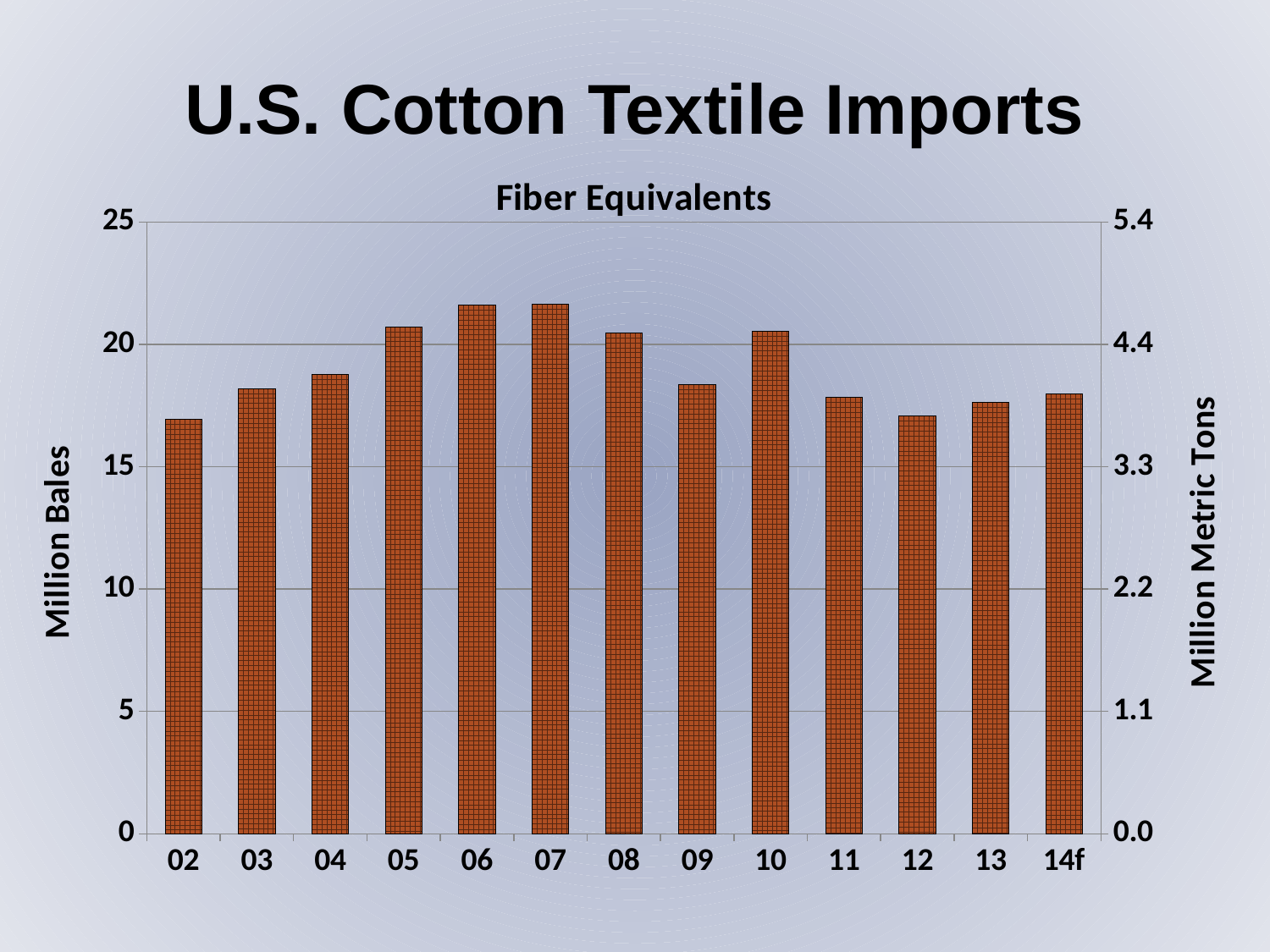
Is the value for 12 greater or less than 20 million bales? less Do the values rise or fall from 02 to 06? rise What kind of chart is shown on the slide? bar chart Is the value for 09 greater or less than 15 million bales? greater Is the value for 02 greater or less than 20 million bales? less Which has the larger value, 10 or 11? 10 What is the label on the left vertical axis? Million Bales Which has the larger value, 05 or 04? 05 What is the label on the right vertical axis? Million Metric Tons How many years (categories) are plotted on the x axis? 13